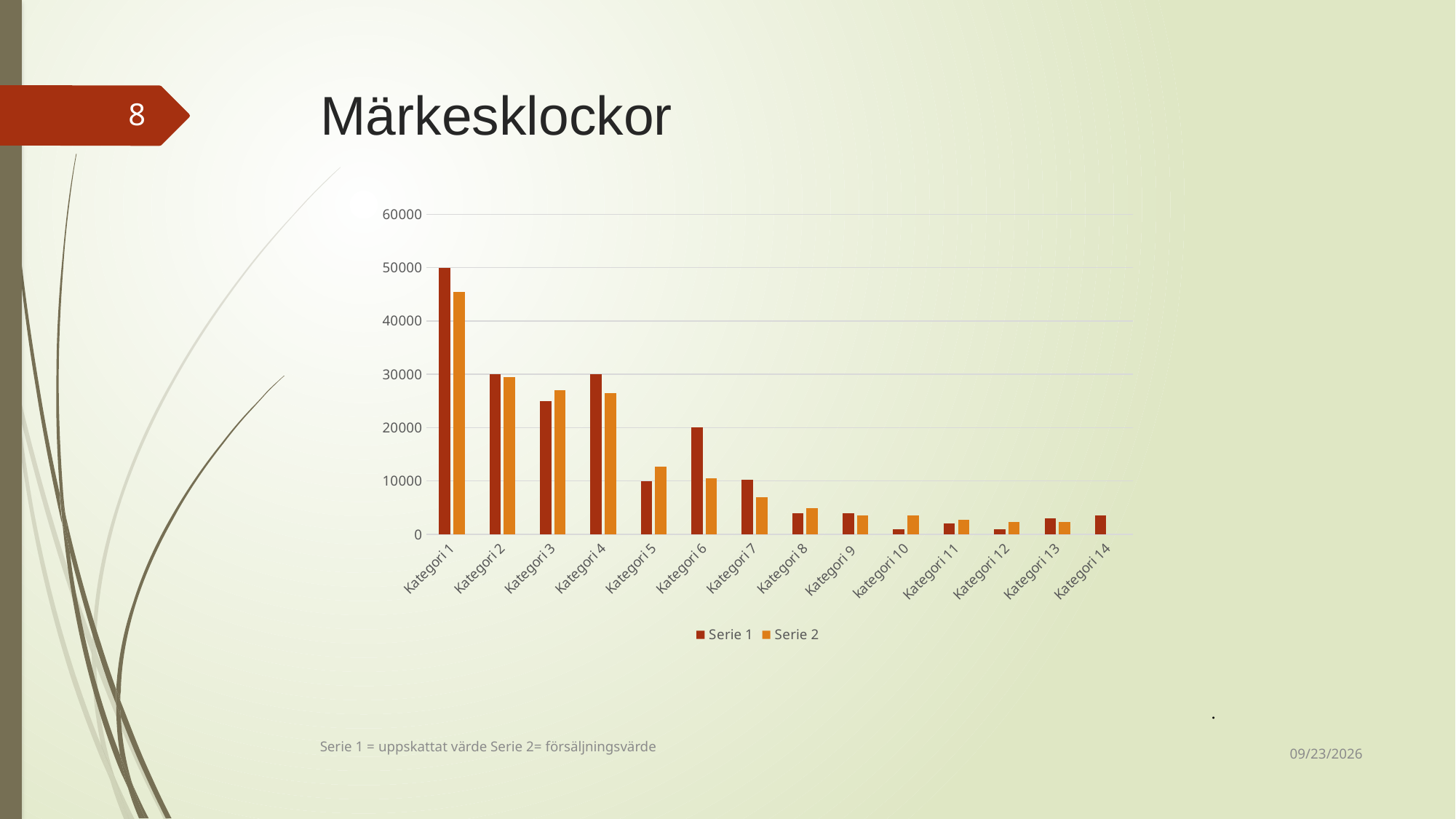
Which is larger for Kategori 5, the Serie 1 value or the Serie 2 value? Serie 2 How many categories are shown on the x axis of the chart? 14 What is the Serie 1 value for Kategori 6? 20000 What is the title of the slide containing the chart? Märkesklockor Is the Serie 2 value for Kategori 7 greater or less than 10000? less Which category has the highest Serie 1 value? Kategori 1 What kind of chart is shown on the slide? bar chart Which category has the highest Serie 2 value? Kategori 1 Do the Serie 1 values generally rise or fall from Kategori 1 to Kategori 14? fall What is the Serie 1 value for Kategori 1? 50000 How many series does the chart legend list? 2 Is the Serie 2 value for Kategori 1 greater or less than 40000? greater